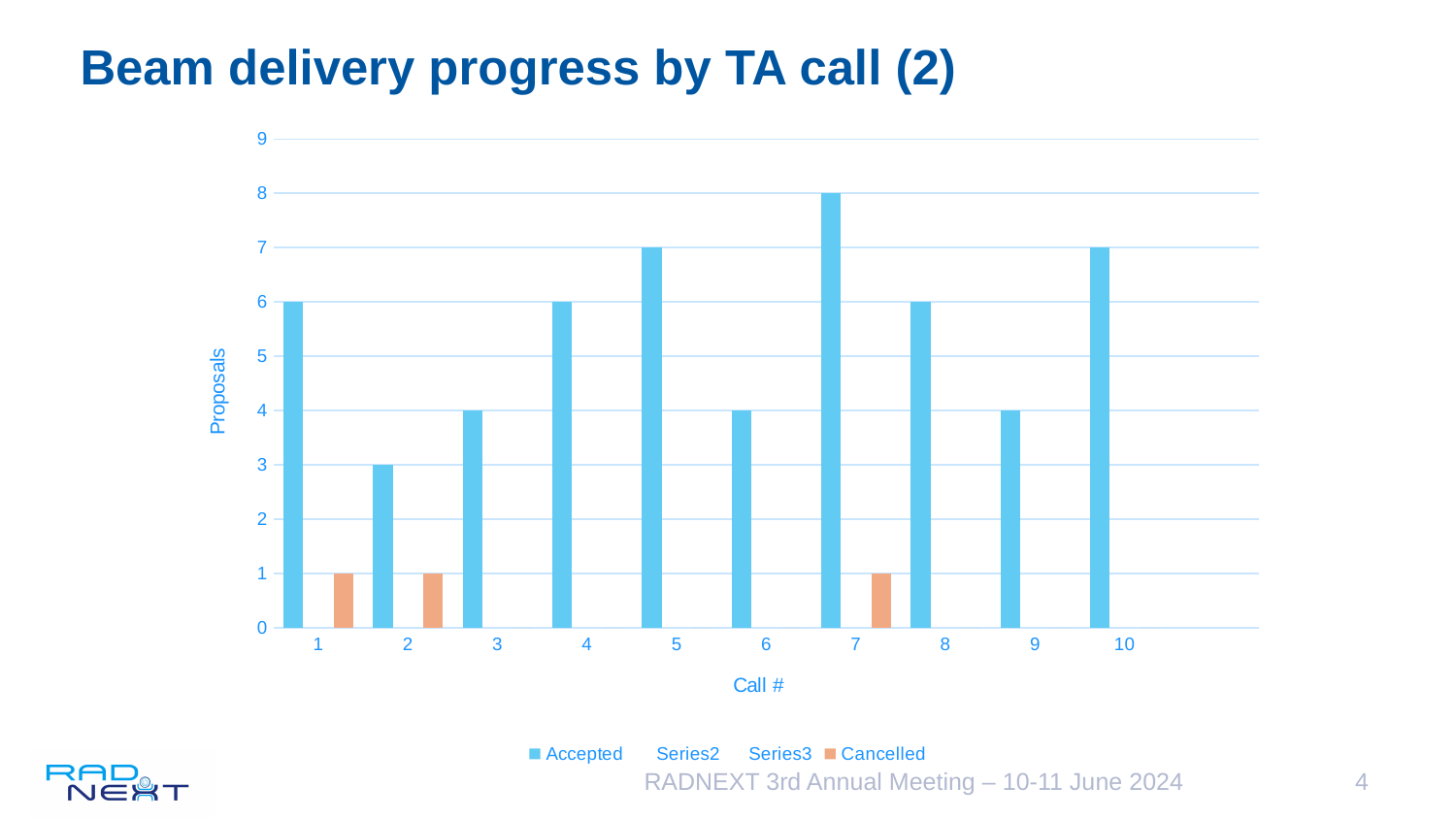
Which has more Accepted proposals, call 5 or call 6? call 5 What kind of chart is shown on the slide? bar chart How many Cancelled proposals are shown for call 1? 1 What is the label of the y axis? Proposals What is the difference between the Accepted proposals for call 7 and call 2? 5 What is the title of the chart slide? Beam delivery progress by TA call (2) How many Accepted proposals are shown for call 7? 8 How many series does the legend list? 4 How many Accepted proposals are shown for call 2? 3 Which call has the highest number of Accepted proposals? 7 How many calls are shown on the x axis? 10 Which call has the lowest number of Accepted proposals? 2